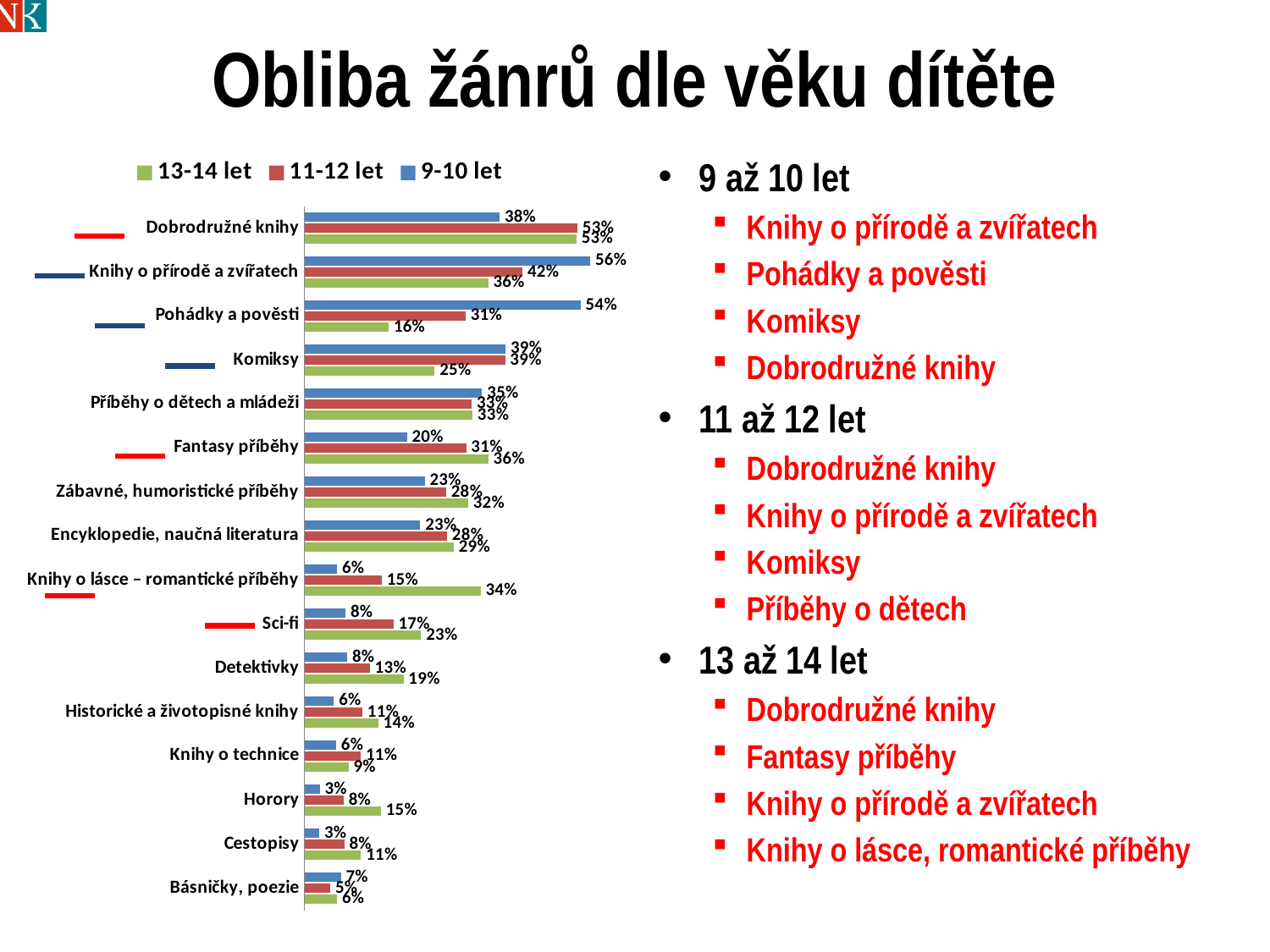
How many series does the chart legend list? 3 What is the difference between the 13-14 let and 9-10 let values for Knihy o lásce – romantické příběhy? 28% What is the difference between the 9-10 let and 13-14 let values for Pohádky a pověsti? 38% What is the value for Fantasy příběhy in the 11-12 let series? 31% Which category has the lowest value in the 13-14 let series? Básničky, poezie Which category has the highest value in the 9-10 let series? Knihy o přírodě a zvířatech How many genre categories are plotted in the chart? 16 Which colour represents the 11-12 let series in the chart? red What is the value for Pohádky a pověsti in the 9-10 let series? 54% What kind of chart is shown on the slide? bar chart For Horory, which series has the larger value: 13-14 let or 9-10 let? 13-14 let What is the value for Knihy o lásce – romantické příběhy in the 13-14 let series? 34%